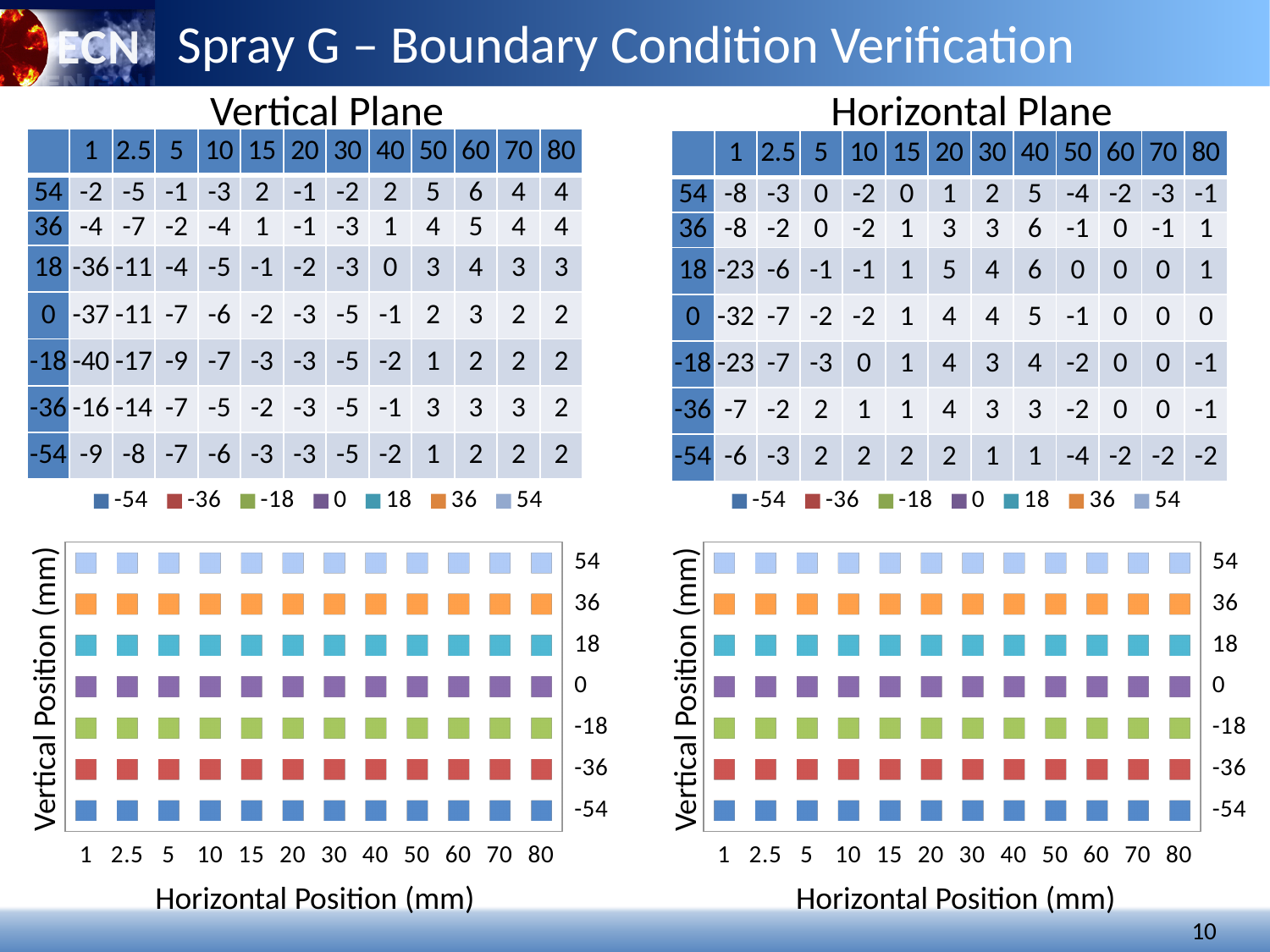
In the Horizontal Plane table, what is the value at vertical position 18 and horizontal position 40? 6 What is the largest horizontal position label on the x axis of the Vertical Plane chart? 80 In the Horizontal Plane table, what is the value at vertical position 0 and horizontal position 1? -32 What is the x-axis title of the Vertical Plane chart? Horizontal Position (mm) What is the y-axis title of the Horizontal Plane chart? Vertical Position (mm) In the Horizontal Plane table, what is the difference between the value at vertical position 0, horizontal position 1 and the value at vertical position 0, horizontal position 2.5? 25 In the Vertical Plane table, what is the value at vertical position -18 and horizontal position 1? -40 How many horizontal positions are plotted along the x axis of the Horizontal Plane chart? 12 Which legend entry in the Horizontal Plane chart is shown in orange? 36 In the Vertical Plane table, what is the value at vertical position 0 and horizontal position 1? -37 In the Vertical Plane table, which is larger: the value at vertical position 54, horizontal position 60, or the value at vertical position -54, horizontal position 60? vertical position 54, horizontal position 60 How many series does the legend of the Vertical Plane chart list? 7